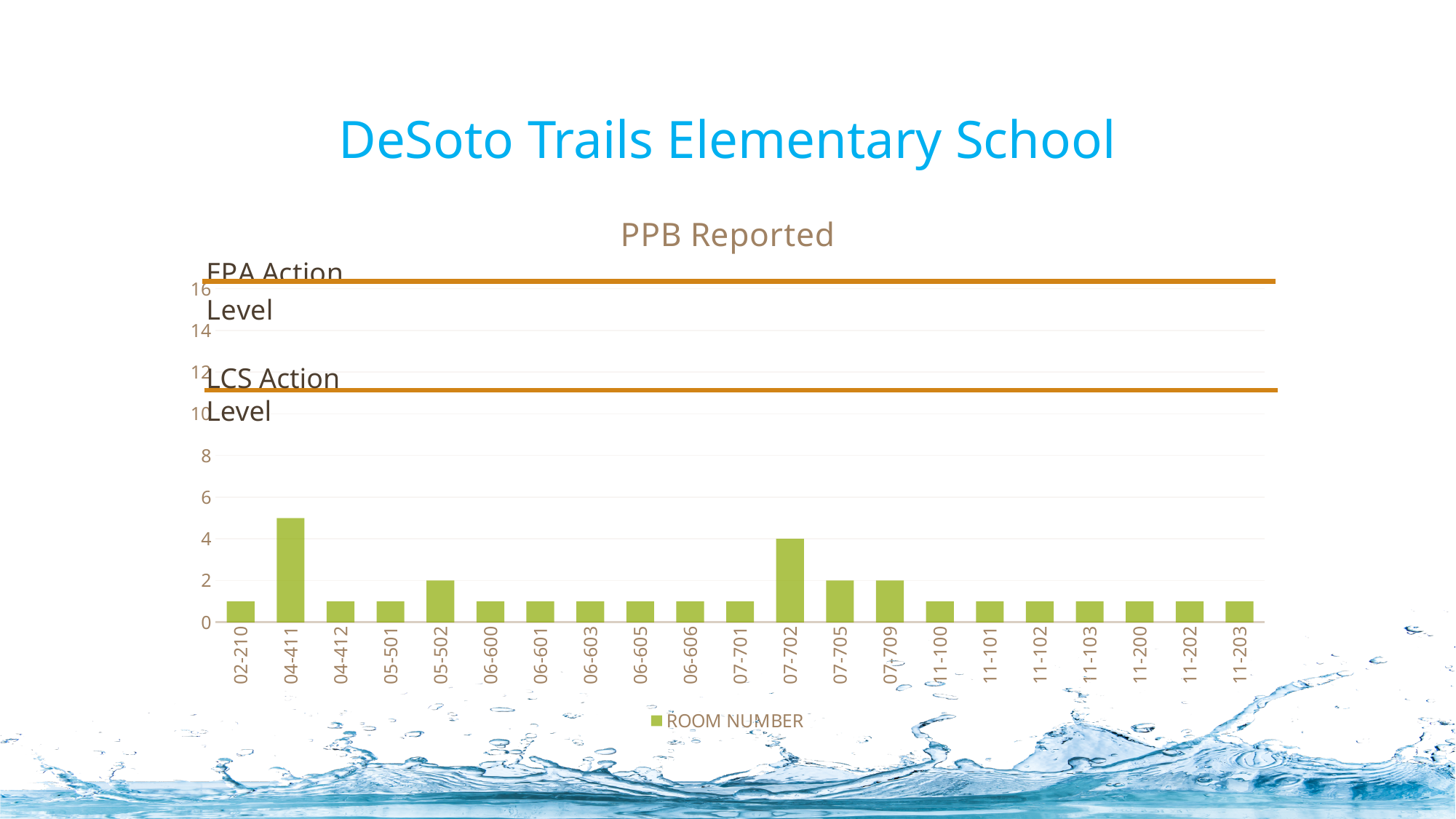
Is the value for room 11-101 greater or less than 2? less How many room number categories are plotted on the x axis? 21 Is the value for room 04-411 greater or less than 4? greater What type of chart is shown on the slide? bar chart Which has a larger value, room 04-411 or room 07-702? 04-411 What is the PPB reported value for room 05-502? 2 Which room number has the highest PPB reported value? 04-411 What is the difference between the values for room 07-702 and room 07-705? 2 What is the PPB reported value for room 07-709? 2 What is the title of the chart? PPB Reported What is the PPB reported value for room 07-702? 4 How many series does the legend list? 1